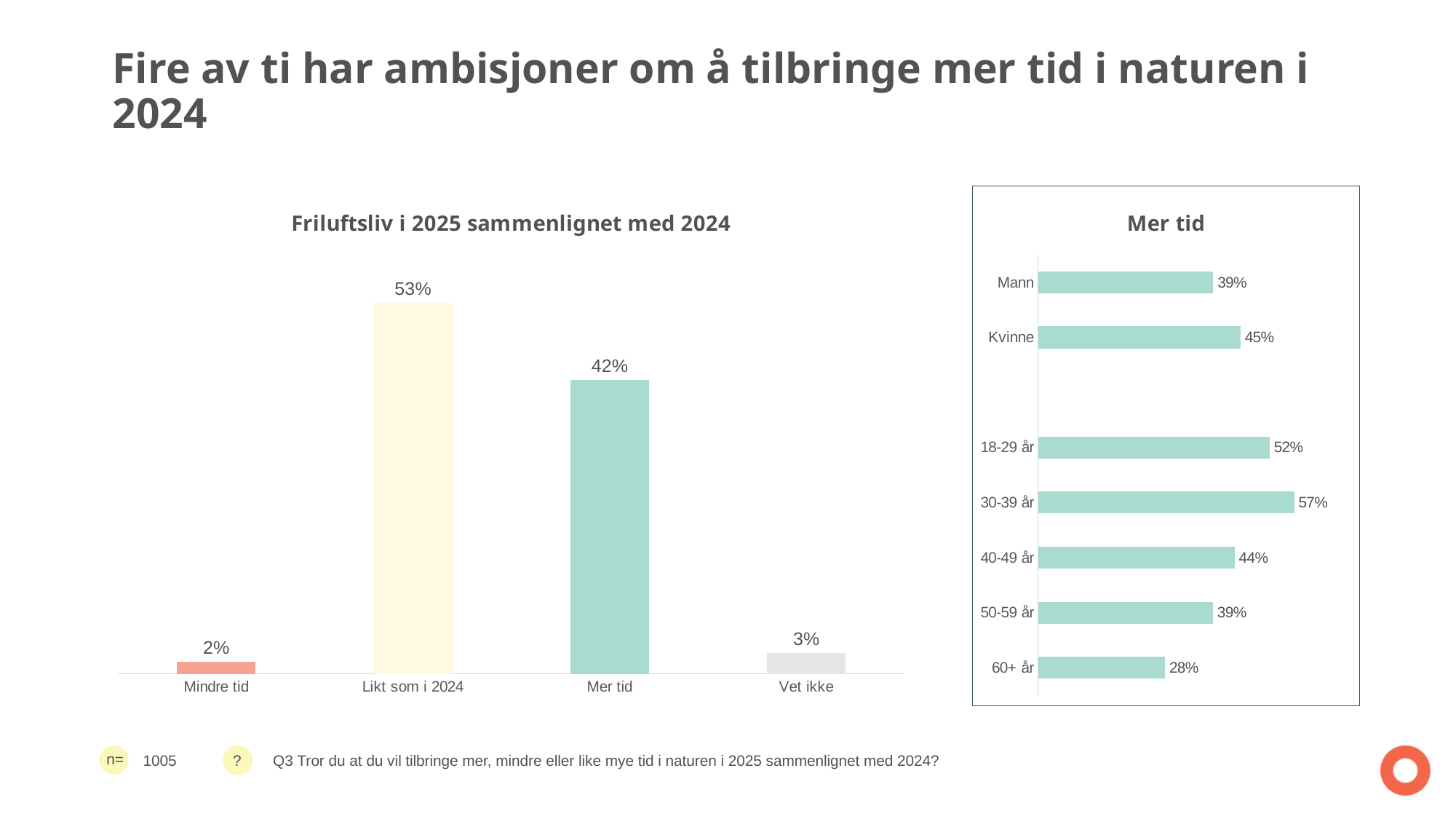
In the chart titled "Mer tid", which is larger, the value for "18-29 år" or the value for "40-49 år"? 18-29 år What kind of chart is the chart titled "Friluftsliv i 2025 sammenlignet med 2024"? Bar chart In the chart titled "Friluftsliv i 2025 sammenlignet med 2024", which category has the lowest value? Mindre tid In the chart titled "Friluftsliv i 2025 sammenlignet med 2024", what is the difference between "Likt som i 2024" and "Mer tid"? 11% In the chart titled "Mer tid", what is the difference between "Kvinne" and "Mann"? 6% In the chart titled "Mer tid", how many categories are shown? 7 In the chart titled "Friluftsliv i 2025 sammenlignet med 2024", which category has the highest value? Likt som i 2024 In the chart titled "Mer tid", what is the value for "Kvinne"? 45% In the chart titled "Friluftsliv i 2025 sammenlignet med 2024", how many categories are shown? 4 In the chart titled "Mer tid", which category has the lowest value? 60+ år In the chart titled "Mer tid", which category has the highest value? 30-39 år In the chart titled "Friluftsliv i 2025 sammenlignet med 2024", what is the value for "Mer tid"? 42%